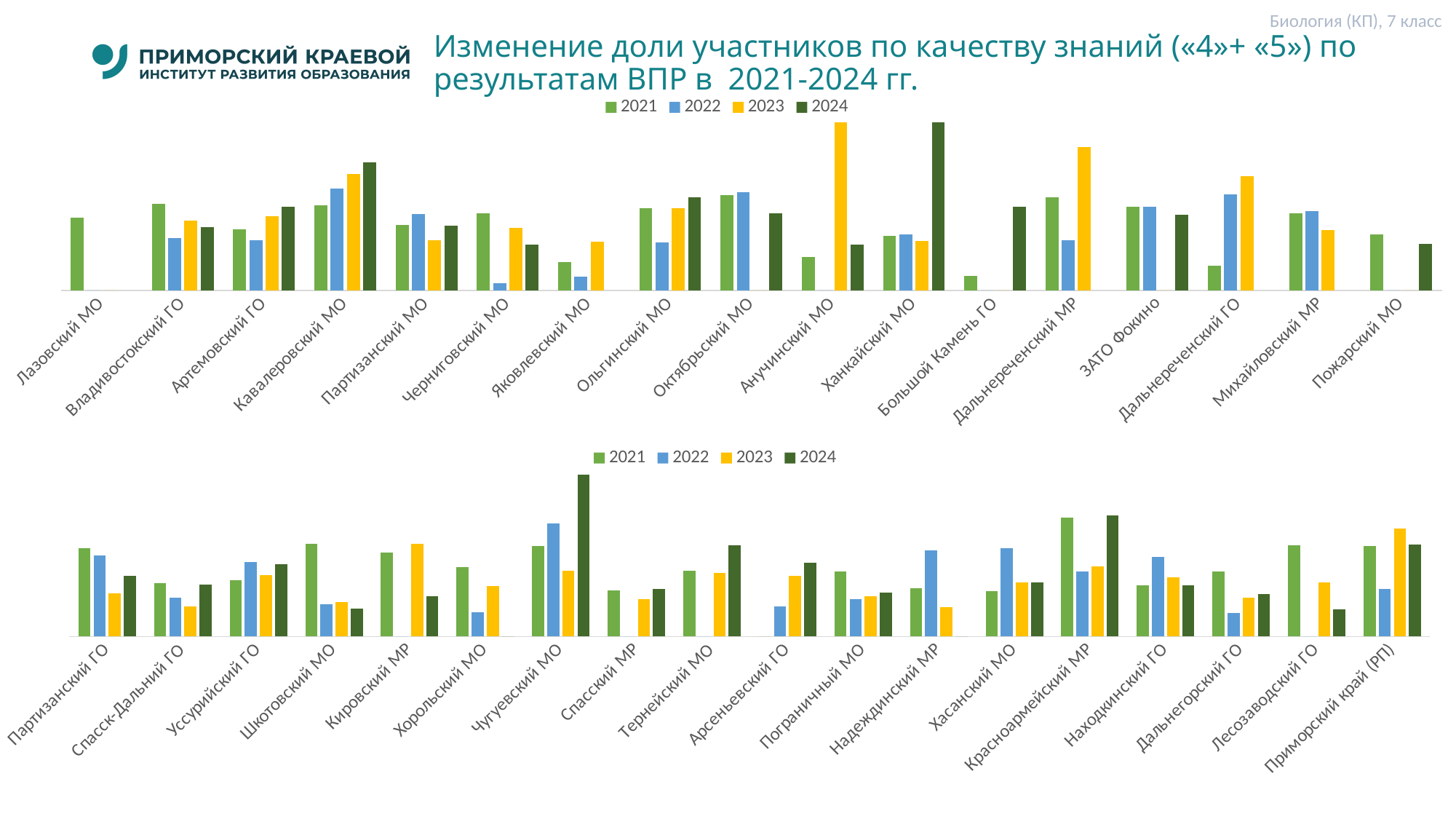
In the bottom chart, is the 2024 bar or the 2022 bar taller for Красноармейский МР? 2024 What kind of chart is the top chart on the slide? bar chart In the bottom chart, which year has the tallest bar for Чугуевский МО? 2024 How many categories are shown on the x axis of the top chart? 17 How many categories are shown on the x axis of the bottom chart? 18 In the top chart, which year has the tallest bar for Ханкайский МО? 2024 In the bottom chart, which year has the tallest bar for Надеждинский МР? 2022 In the bottom chart, which year has the shortest bar for Дальнегорский ГО? 2022 How many series does the legend of the top chart list? 4 Which series is shown in yellow in the legend of the top chart? 2023